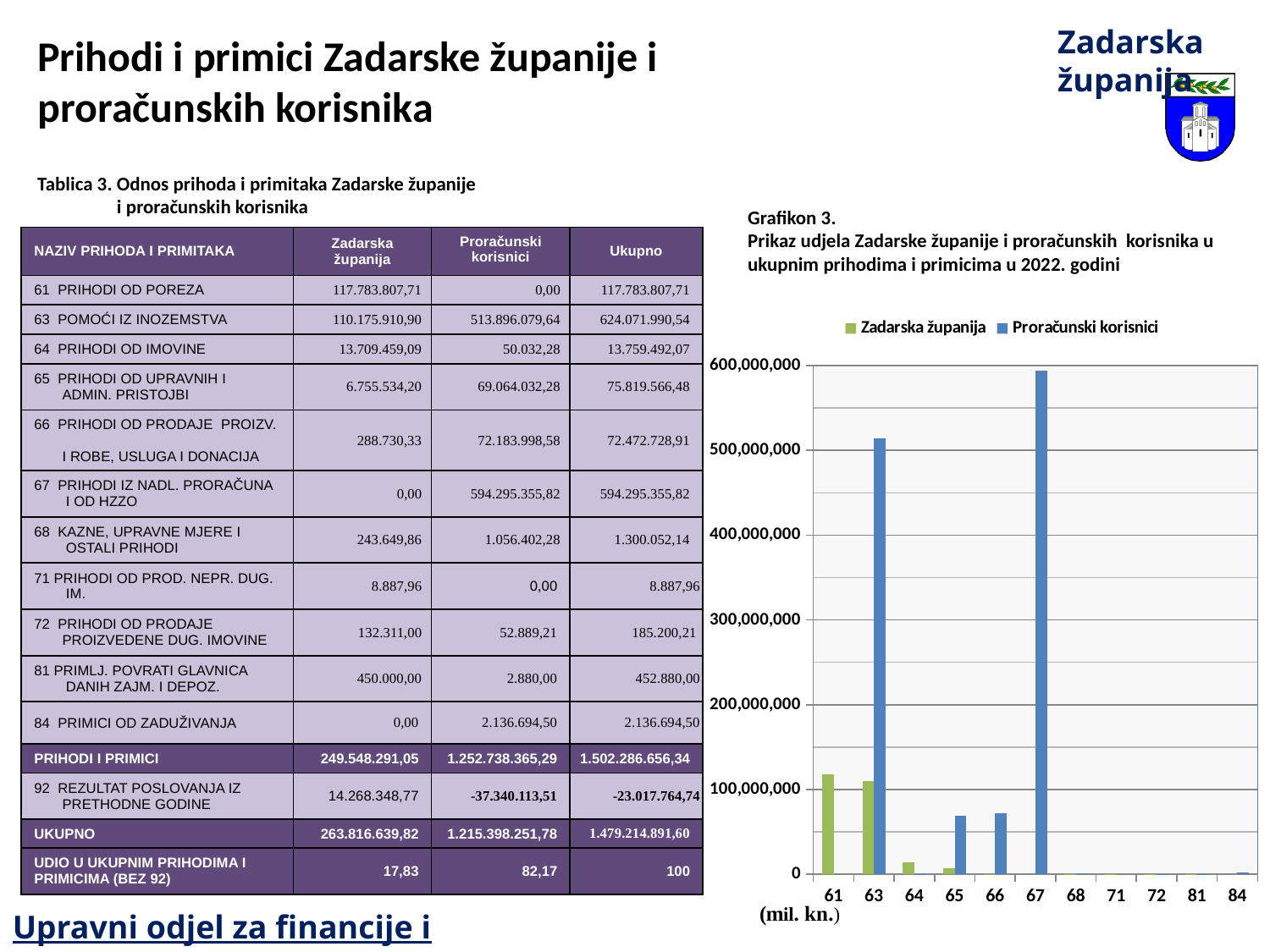
Is the Zadarska županija value for category 61 greater or less than 100,000,000? greater For category 61, which series has the larger value: Zadarska županija or Proračunski korisnici? Zadarska županija Which is larger for Proračunski korisnici: the value for category 67 or for category 63? 67 Is the Proračunski korisnici value for category 65 greater or less than 100,000,000? less What unit label is printed below the x axis of the chart? (mil. kn.) Which series is shown in green in the chart? Zadarska županija What kind of chart is shown on the slide? bar chart How many categories are shown on the x axis of the chart? 11 Is the Proračunski korisnici value for category 67 greater or less than 500,000,000? greater Which category has the highest bar in the chart? 67 How many series does the chart legend list? 2